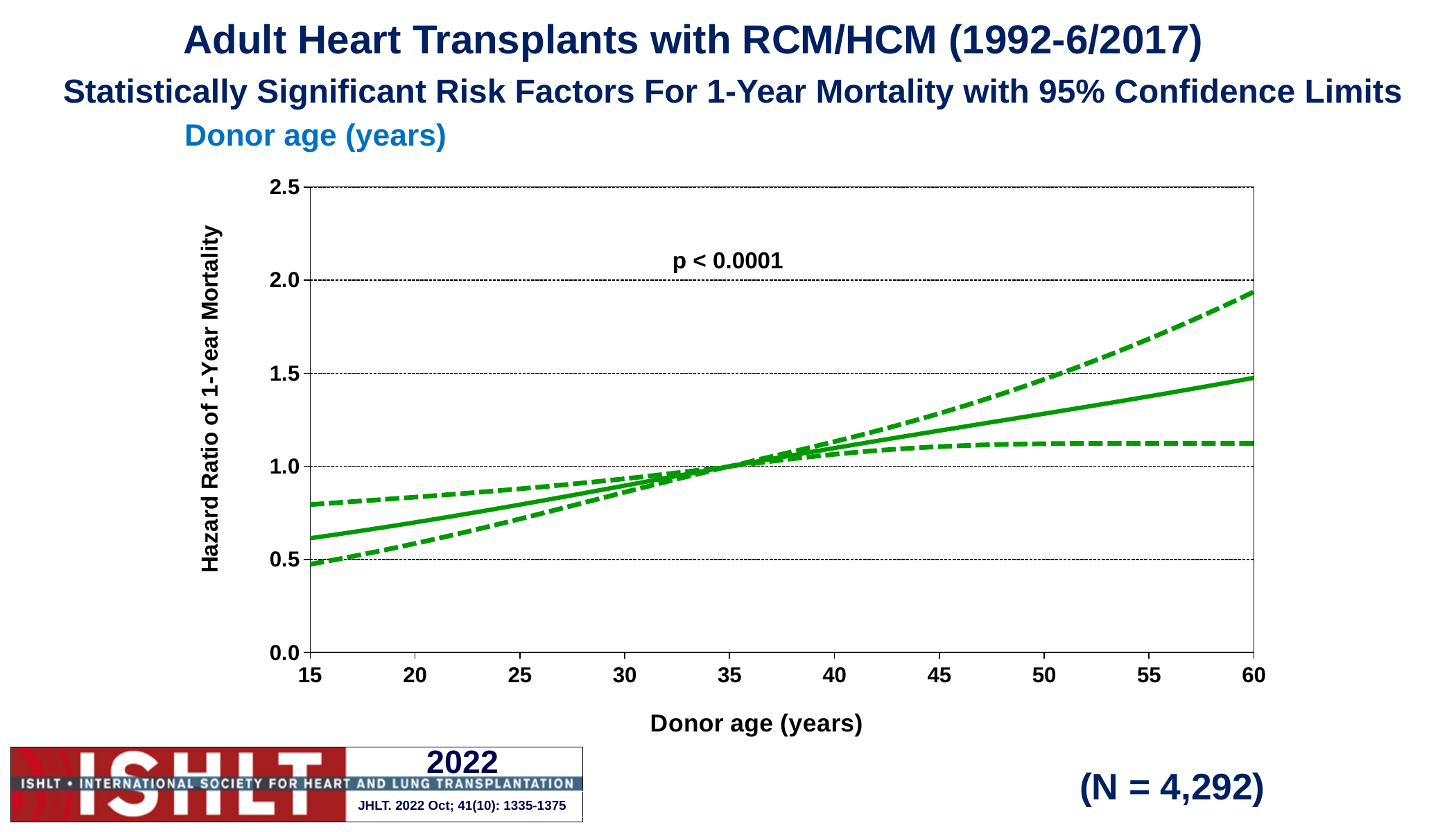
Is the lower 95% confidence limit (lower dashed line) at donor age 60 greater or less than 1.0? greater What kind of chart is shown on the slide? line chart Is the hazard ratio (solid line) at donor age 15 greater or less than 0.5? greater Is the upper 95% confidence limit (upper dashed line) at donor age 15 greater or less than 1.0? less What is the label of the y axis? Hazard Ratio of 1-Year Mortality What p-value is printed on the chart? p < 0.0001 Does the hazard ratio of 1-year mortality rise or fall as donor age increases from 15 to 60 years? rise How many tick labels are shown on the x axis (donor age)? 10